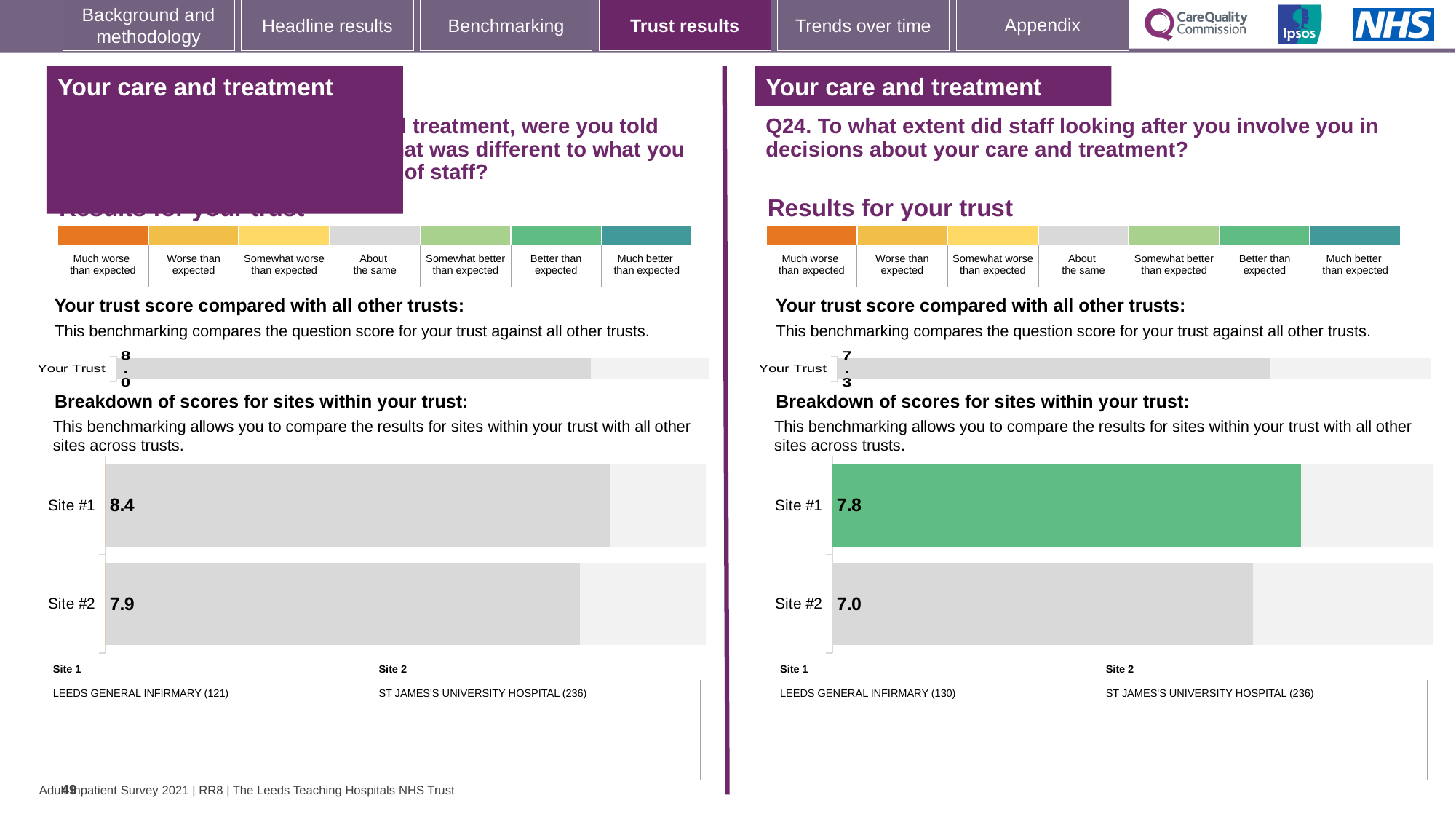
How many sites are shown in the right-hand (Q24) site breakdown chart? 2 On the right-hand (Q24) site breakdown chart, what is the score for Site #2? 7.0 What type of chart is used for the site breakdown on the right-hand (Q24) side of the slide? Bar chart On the right-hand (Q24) site breakdown chart, what is the difference between the Site #1 and Site #2 scores? 0.8 On the left-hand site breakdown chart, what is the score for Site #1? 8.4 On the left-hand site breakdown chart, which site has the lower score? Site #2 On the left-hand site breakdown chart, what is the score for Site #2? 7.9 On the left-hand site breakdown chart, what is the difference between the Site #1 and Site #2 scores? 0.5 On the right-hand (Q24) site breakdown chart, what is the score for Site #1? 7.8 On the left-hand 'Your Trust' bar, what is the trust score shown? 8.0 On the right-hand (Q24) site breakdown chart, which site has the higher score? Site #1 On the right-hand (Q24) 'Your Trust' bar, what is the trust score shown? 7.3